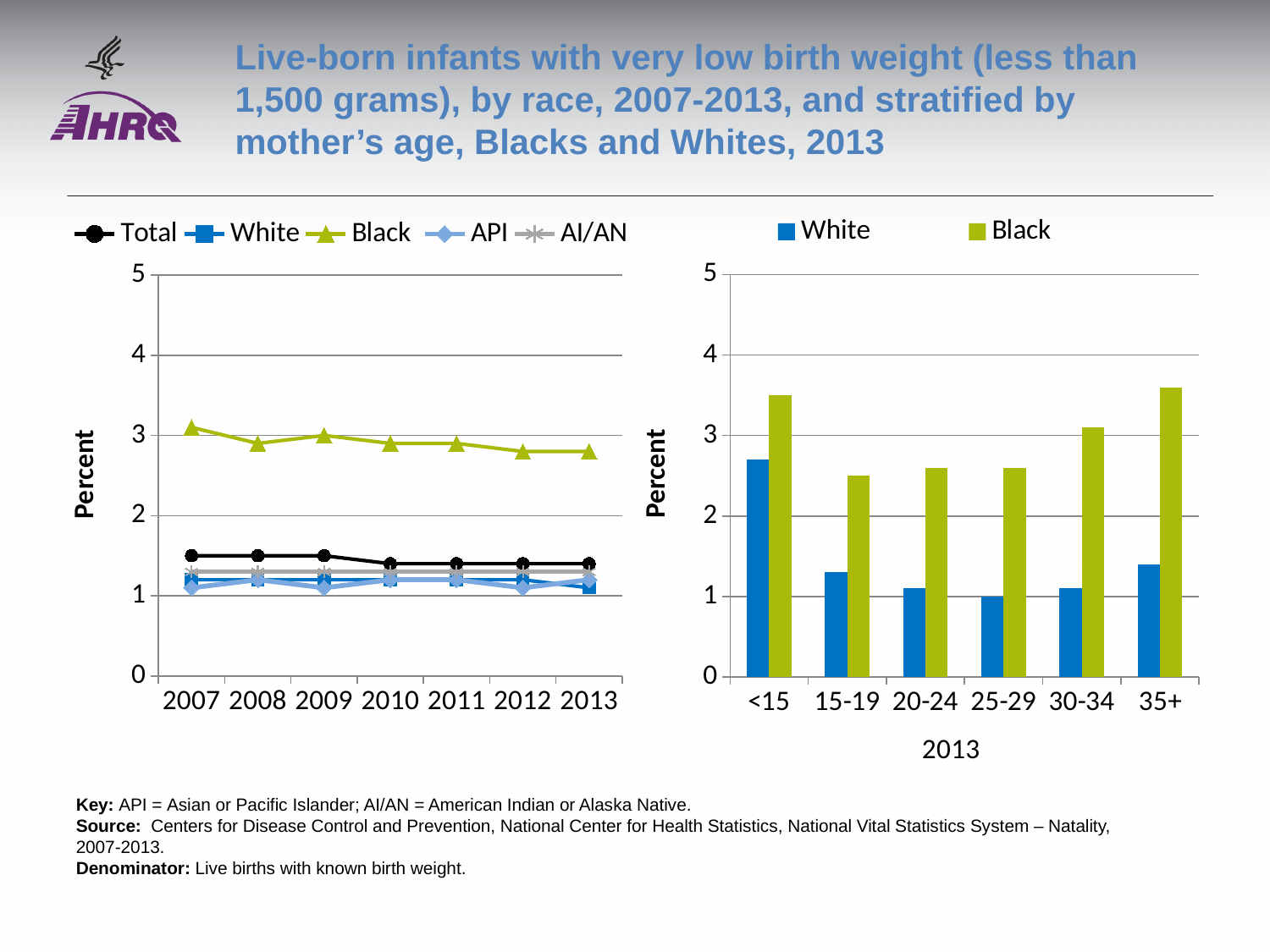
In the left chart, which race group has the highest percentage across all years? Black What kind of chart is the right chart showing 2013 by mother's age? Bar chart In the right chart, is the value for Black in the <15 age group greater or less than 3? greater How many series does the legend of the right chart list? 2 How many years are shown on the x axis of the left chart? 7 In the left chart, does the Black line rise or fall from 2007 to 2013? Fall In the right chart, which is larger for the 30-34 age group, White or Black? Black How many mother's age groups are shown on the right chart? 6 In the left chart, is the value for Black in 2013 greater or less than 3? less How many series does the legend of the left chart list? 5 In the right chart, which age group has the highest value for White? <15 What kind of chart is the left chart showing 2007-2013? Line chart